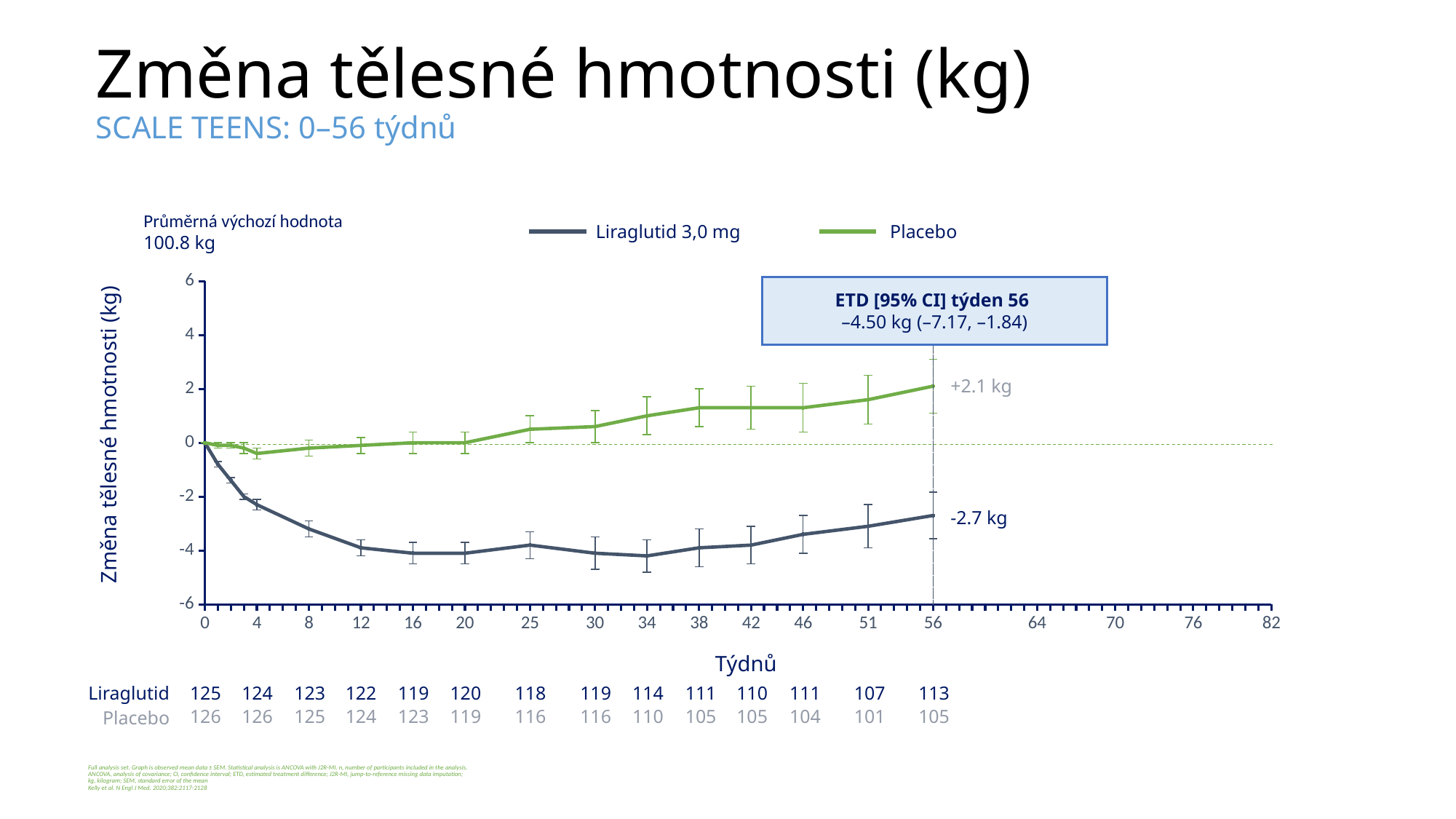
What mean baseline value (Průměrná výchozí hodnota) is shown above the chart? 100.8 kg How many series does the legend list? 2 Does the Liraglutid 3,0 mg line rise or fall from week 0 to week 12? falls Does the Placebo line rise or fall from week 0 to week 56? rises Is the value for Liraglutid 3,0 mg at week 16 greater or less than -2? less At week 56, which series has the higher value, Liraglutid 3,0 mg or Placebo? Placebo What is the difference between the Placebo and Liraglutid 3,0 mg values at week 56? 4.8 kg What kind of chart is shown on the slide? line chart What is the change in body weight for Liraglutid 3,0 mg at week 56? -2.7 kg What is the ETD [95% CI] at week 56 shown in the box on the chart? –4.50 kg (–7.17, –1.84) Is the value for Placebo at week 38 greater or less than 2? less What is the change in body weight for Placebo at week 56? +2.1 kg